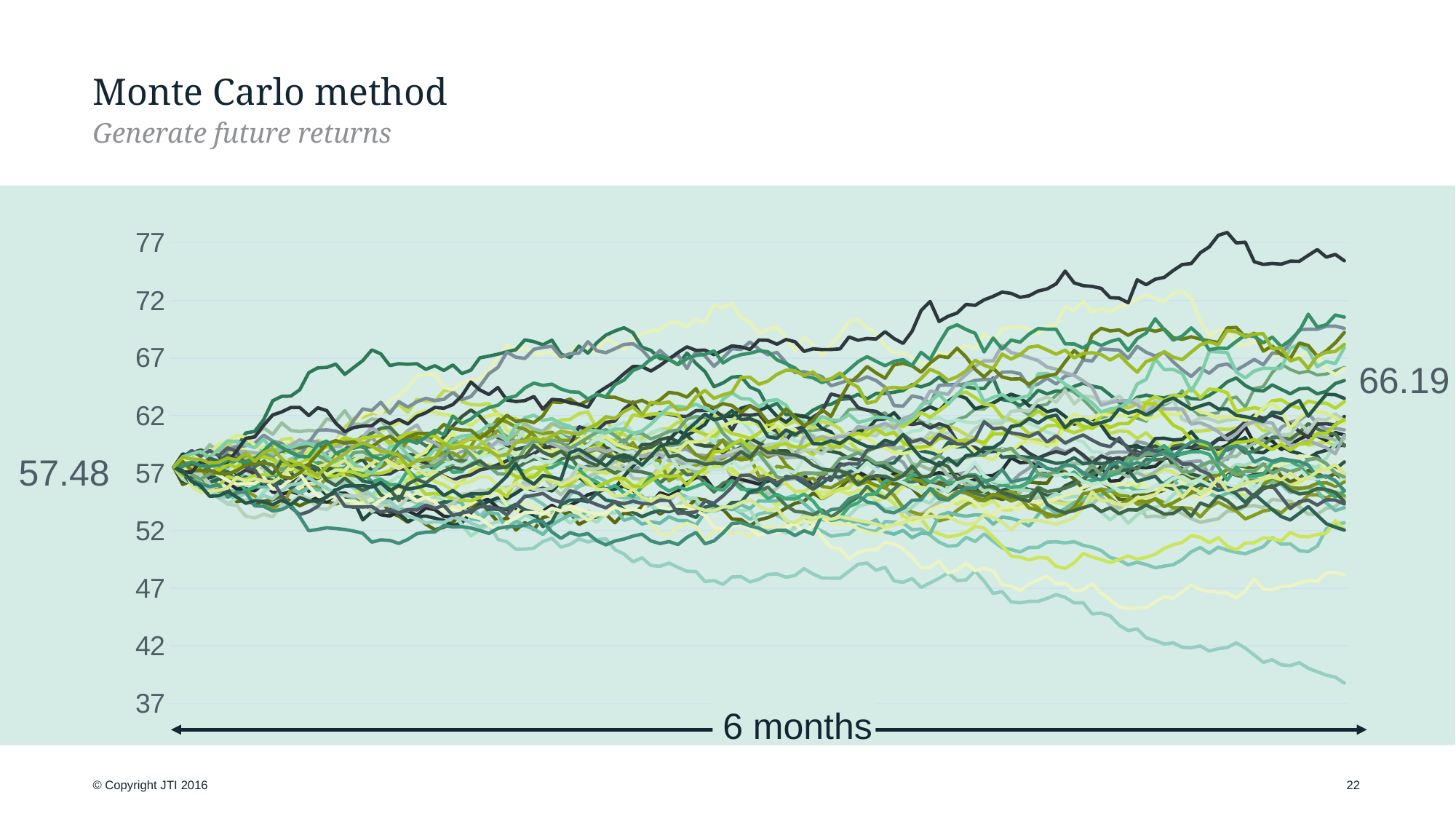
What kind of chart is shown on the slide? line chart Which is larger, the value labelled on the right of the chart or the starting value labelled on the left? 66.19 on the right Is the final value of the lowest simulated path greater or less than 42? less Is the final value of the highest simulated path greater or less than 72? greater What is the highest value shown on the vertical axis? 77 What is the difference between the value labelled on the right (66.19) and the starting value labelled on the left (57.48)? 8.71 What time span does the horizontal arrow under the chart indicate? 6 months What starting value is labelled on the left side of the chart? 57.48 What value is labelled on the right side of the chart at the end of the period? 66.19 What is the lowest value shown on the vertical axis? 37 Does the simulated path that ends lowest rise or fall over the period? fall Is the starting value of the simulated paths greater or less than 52? greater